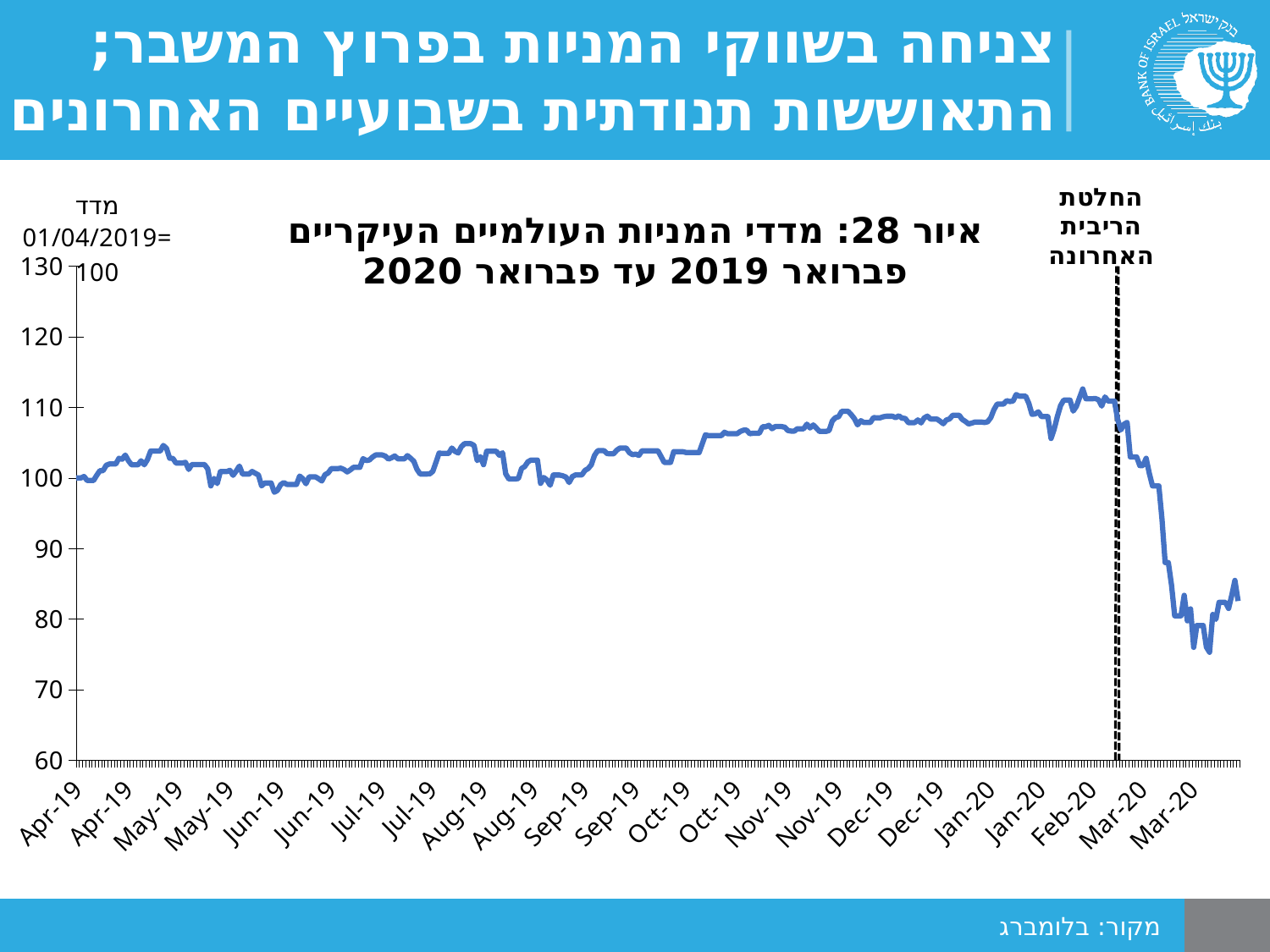
What is the highest value shown on the vertical axis of the chart? 130 Is the value of the index in Jun-19 greater or less than 110? less Does the index generally rise or fall between Sep-19 and Jan-20? rise Is the value of the index in Jan-20 greater or less than 100? greater What is the source cited at the bottom of the slide? בלומברג Is the peak of the index in Feb-20 greater or less than 110? greater What is the title of the chart on the slide? איור 28: מדדי המניות העולמיים העיקריים פברואר 2019 עד פברואר 2020 Does the index rise or fall between Feb-20 and Mar-20? fall What kind of chart is shown on the slide? line chart What is the base value of the index on 01/04/2019, as printed on the chart? 100